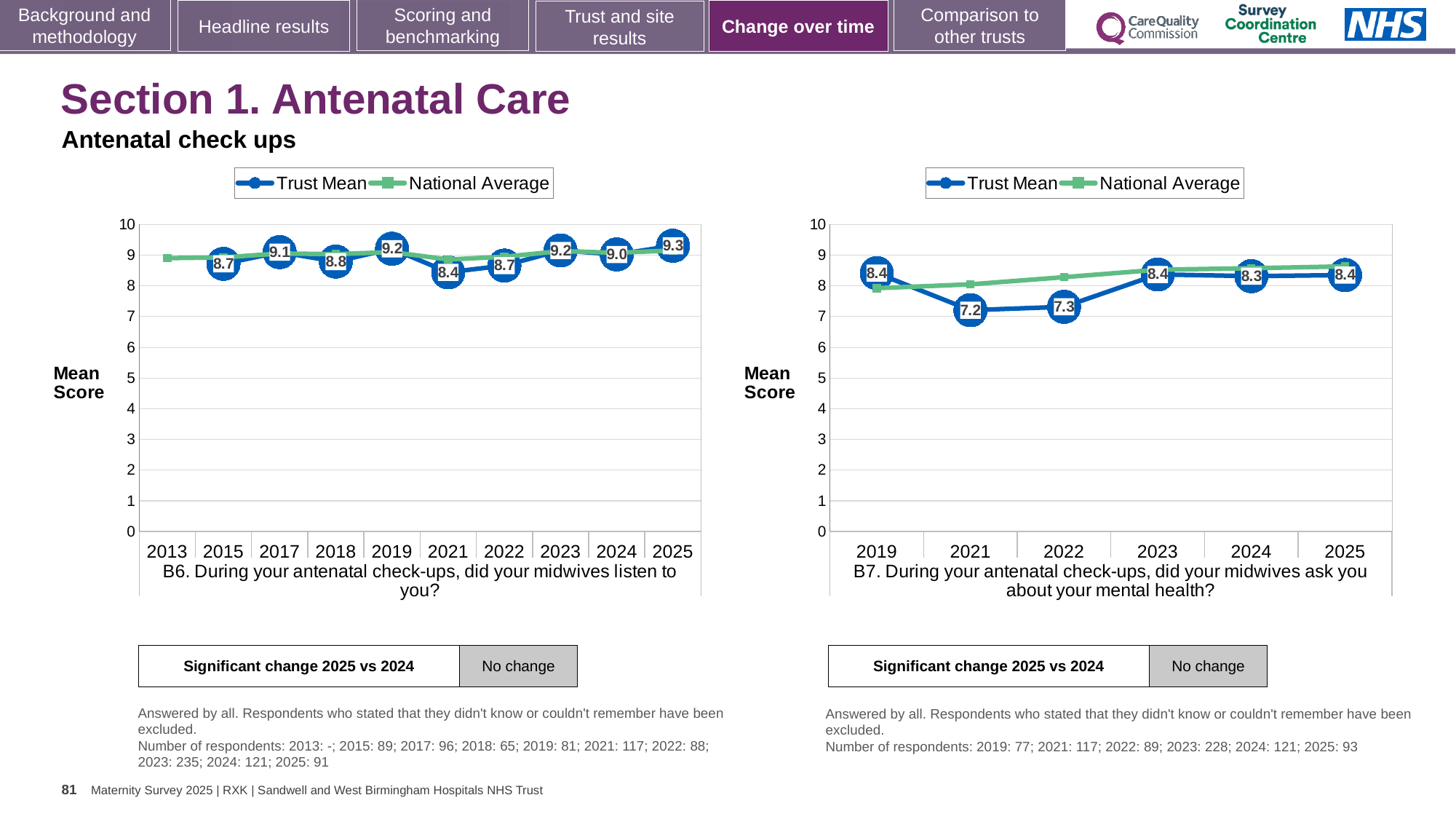
In the B6 chart (left), which year has the lowest Trust Mean? 2021 In the B6 chart (left), what is the Trust Mean for 2025? 9.3 In the B7 chart (right), what is the difference between the Trust Mean for 2023 and the Trust Mean for 2021? 1.2 In the B7 chart (right), which year has the lowest Trust Mean? 2021 In the B6 chart (left), what is the Trust Mean for 2021? 8.4 In the B6 chart (left), what is the difference between the Trust Mean for 2025 and the Trust Mean for 2024? 0.3 In the B7 chart (right), is the Trust Mean for 2022 larger or smaller than the Trust Mean for 2023? smaller What kind of chart is the B7 chart (right)? line chart In the B6 chart (left), how many series does the legend list? 2 In the B7 chart (right), what is the Trust Mean for 2021? 7.2 In the B6 chart (left), how many years are shown on the x axis? 10